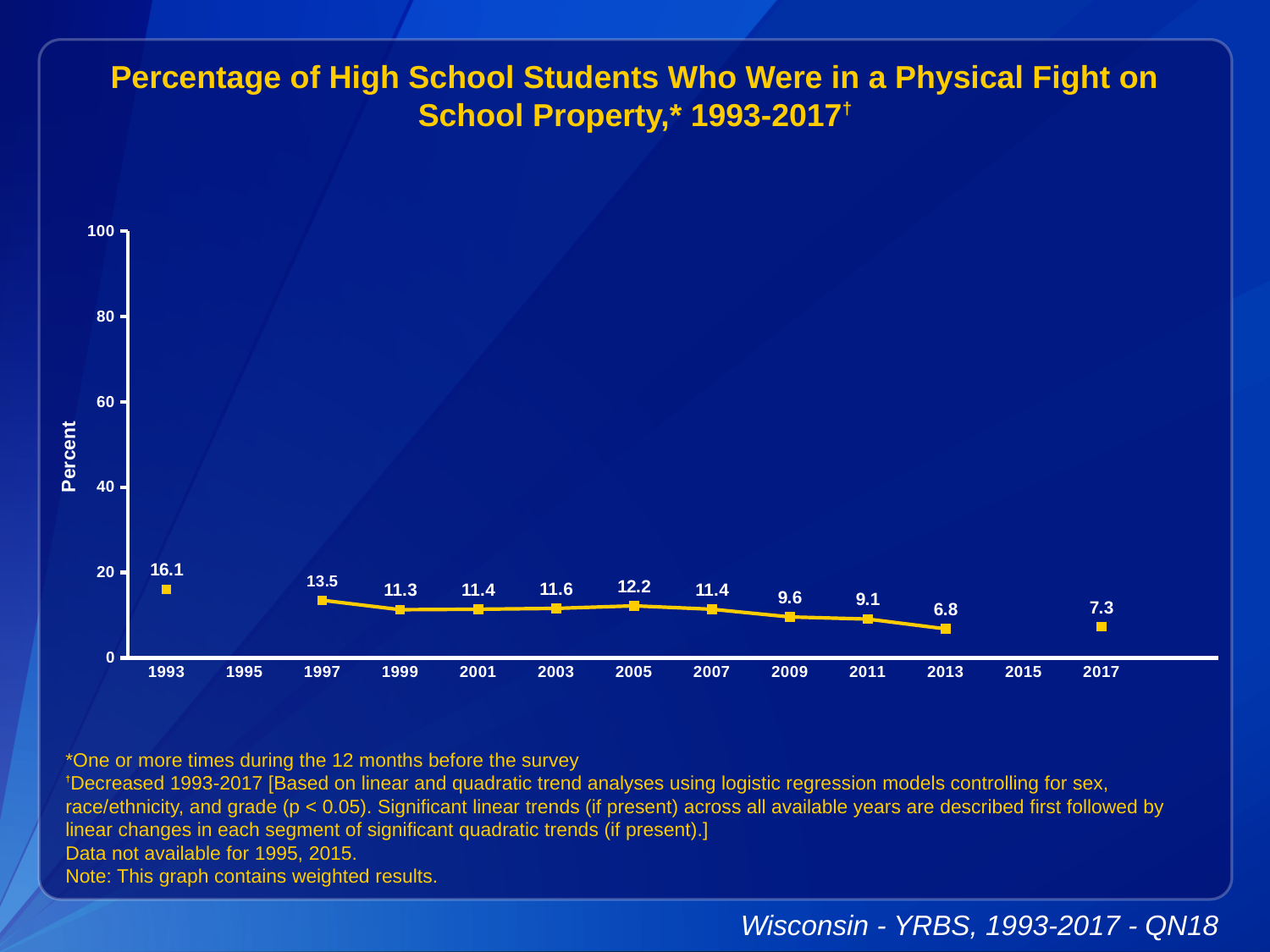
What kind of chart is shown on the slide? line chart How many years have data points plotted on the chart? 11 Is the value for 1997 greater or less than 20? less Do the values generally rise or fall from 1993 to 2017? fall Which year has the lowest value on the chart? 2013 What value is shown for 2005? 12.2 Which year has the highest value on the chart? 1993 What is the label on the y axis? Percent What is the difference between the 1993 value and the 2013 value? 9.3 What value is shown for 2017? 7.3 What was the percentage of high school students who were in a physical fight on school property in 1993? 16.1 Which year has a larger value, 2009 or 2011? 2009